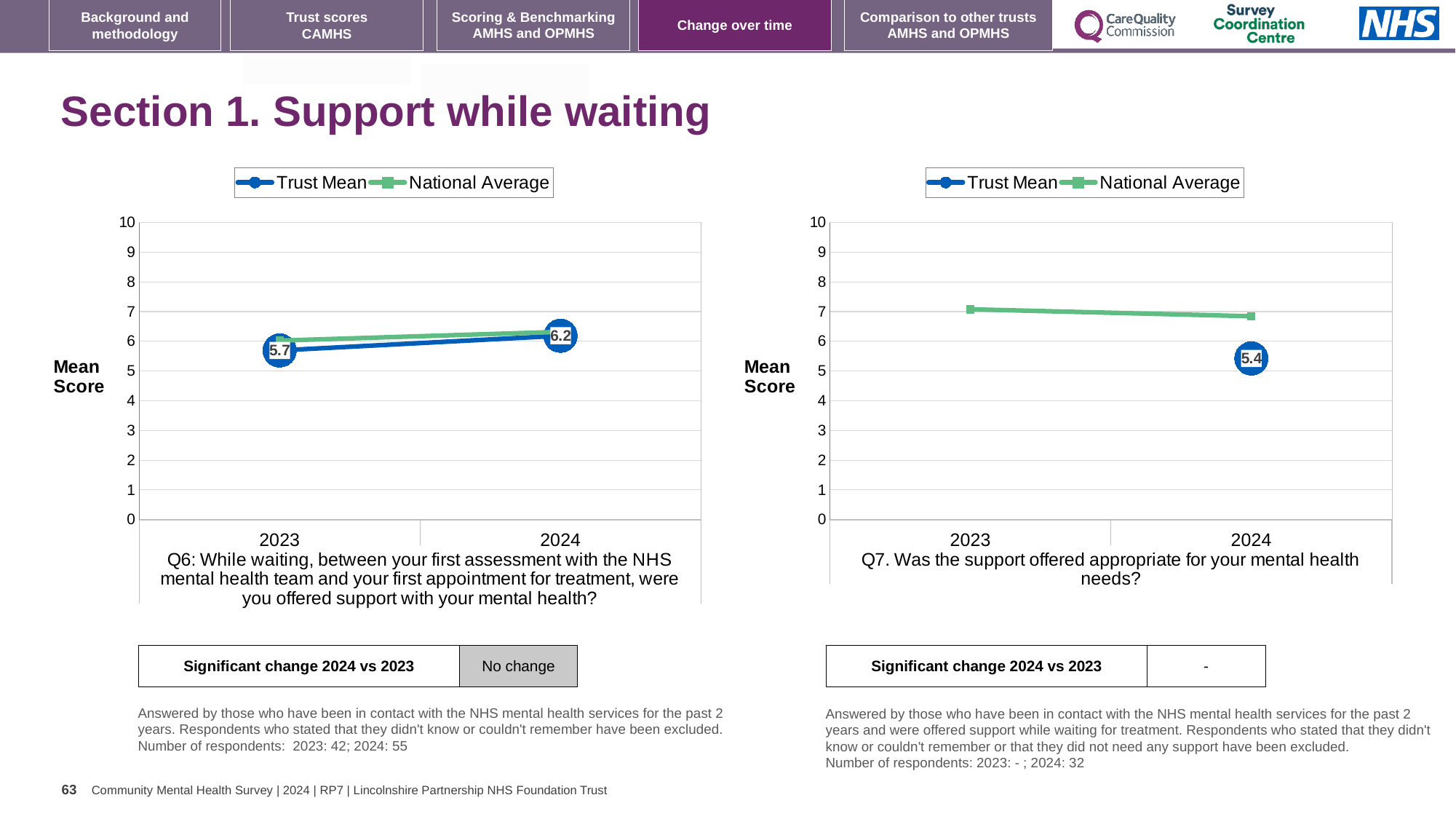
In the left chart (Q6), what is the Trust Mean score for 2023? 5.7 In the right chart (Q7), what is the Trust Mean score for 2024? 5.4 In the right chart (Q7), is the National Average for 2023 greater or less than 8? less How many years are shown on the x axis of the right chart (Q7)? 2 What are the two series named in the legend of the right chart (Q7)? Trust Mean and National Average In the left chart (Q6), does the Trust Mean rise or fall from 2023 to 2024? rise What kind of chart is used on this slide for Q6 and Q7? line chart In the right chart (Q7), does the National Average rise or fall from 2023 to 2024? fall In the left chart (Q6), by how much did the Trust Mean change from 2023 to 2024? 0.5 In the left chart (Q6), what is the Trust Mean score for 2024? 6.2 How many series does the legend of the left chart (Q6) list? 2 In the right chart (Q7), which is larger for 2024: the Trust Mean or the National Average? National Average